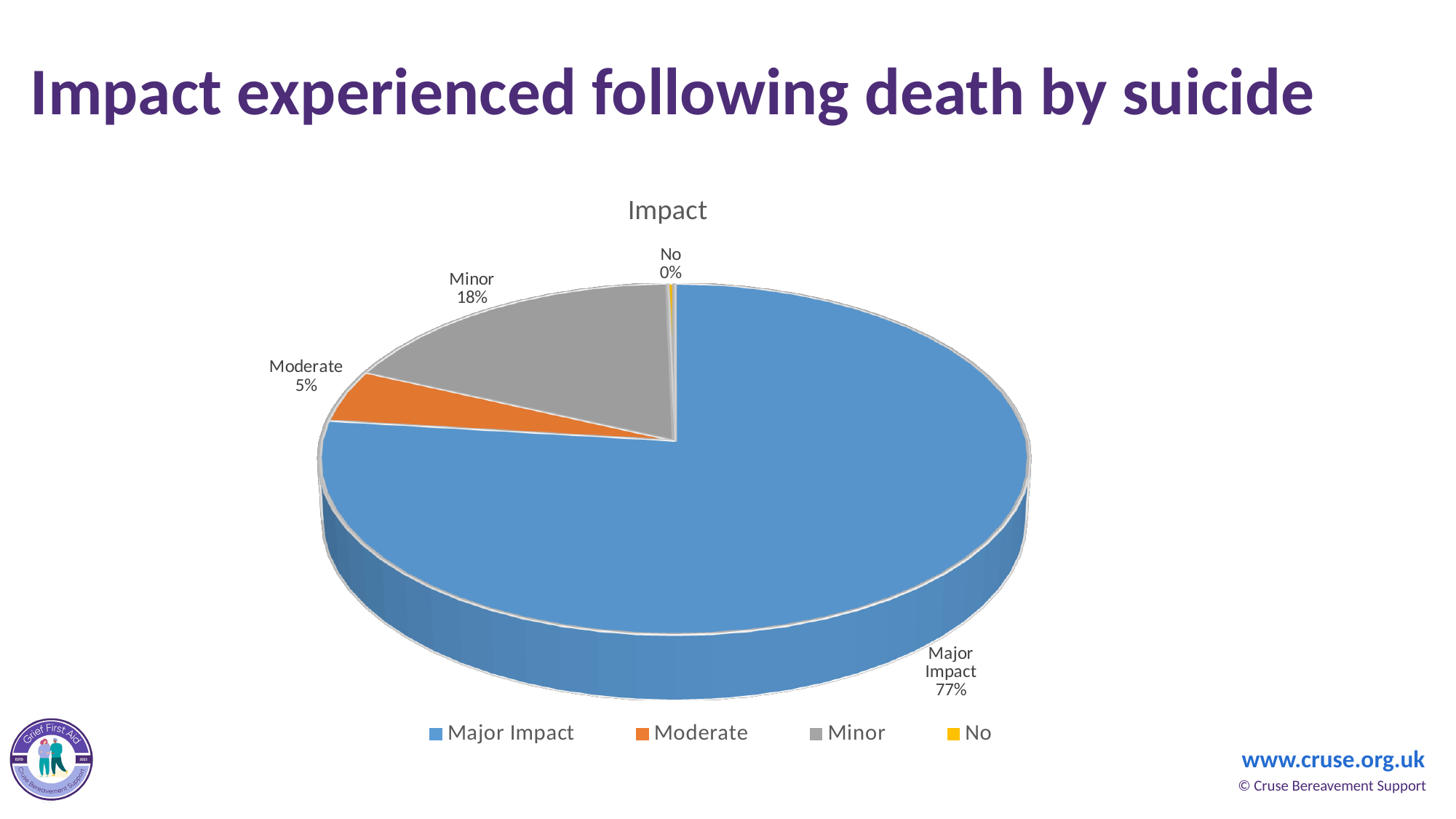
What type of chart is shown on the slide? Pie chart What percentage of the pie is labelled Major Impact? 77% What percentage of the pie is labelled Moderate? 5% Which category has the largest share of the pie? Major Impact What percentage of the pie is labelled Minor? 18% Which category has the smallest share of the pie? No Which slice is larger, Minor or Moderate? Minor What is the chart's title? Impact What percentage of the pie is labelled No? 0% What colour is the Major Impact slice? Blue What is the difference in percentage points between the Minor and Moderate slices? 13 How many categories does the legend list? 4